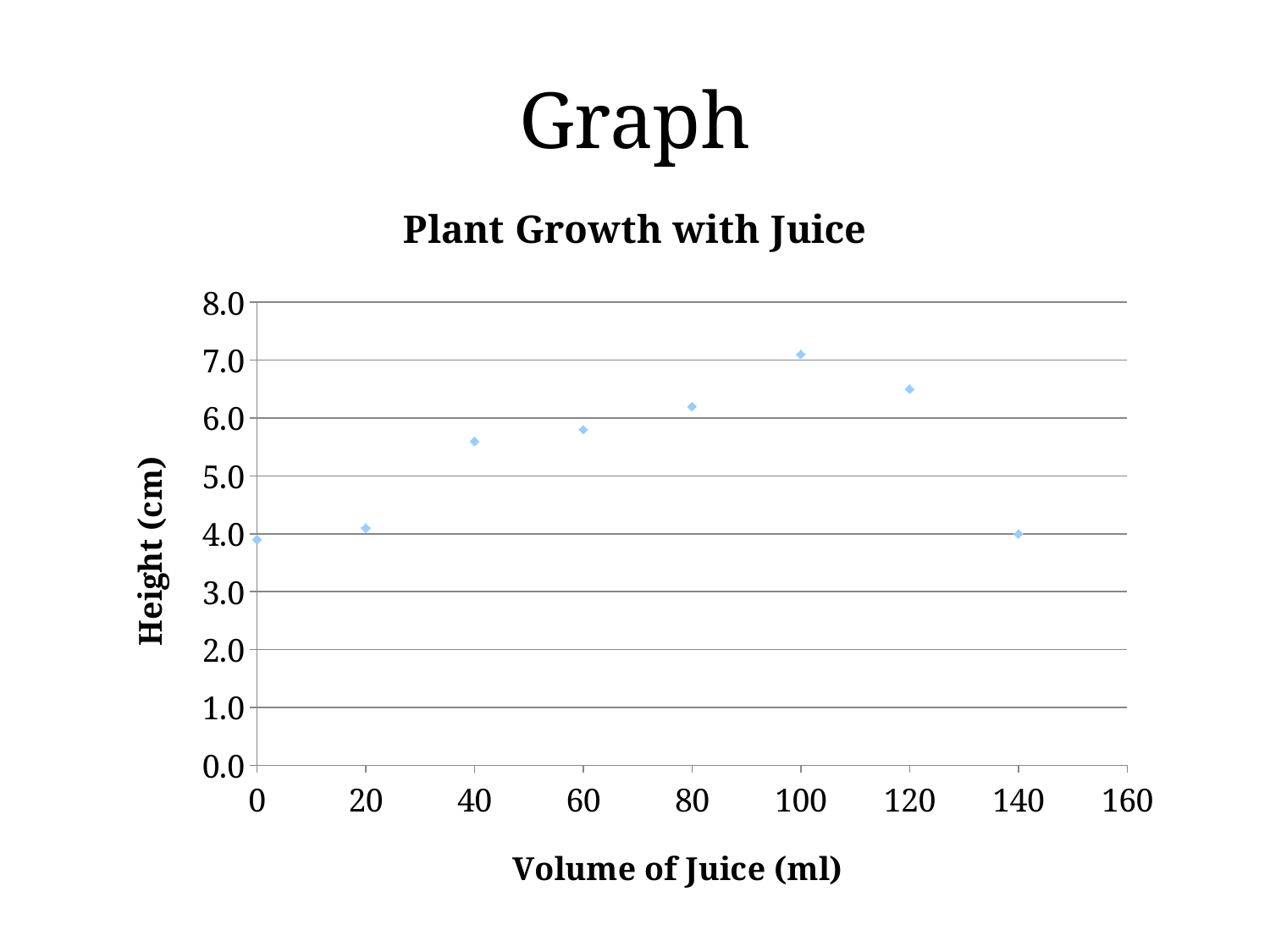
Is the height for 20 ml of juice greater or less than 5.0 cm? less What is the label of the y axis? Height (cm) Is the height for 140 ml of juice greater or less than 5.0 cm? less What is the title of the chart? Plant Growth with Juice At which volume of juice is the plant height highest? 100 ml What kind of chart is shown on the slide? scatter chart Is the height for 120 ml of juice greater or less than 6.0 cm? greater Which has the greater height: 100 ml of juice or 120 ml of juice? 100 ml Which has the greater height: 80 ml of juice or 20 ml of juice? 80 ml How many data points are plotted on the chart? 8